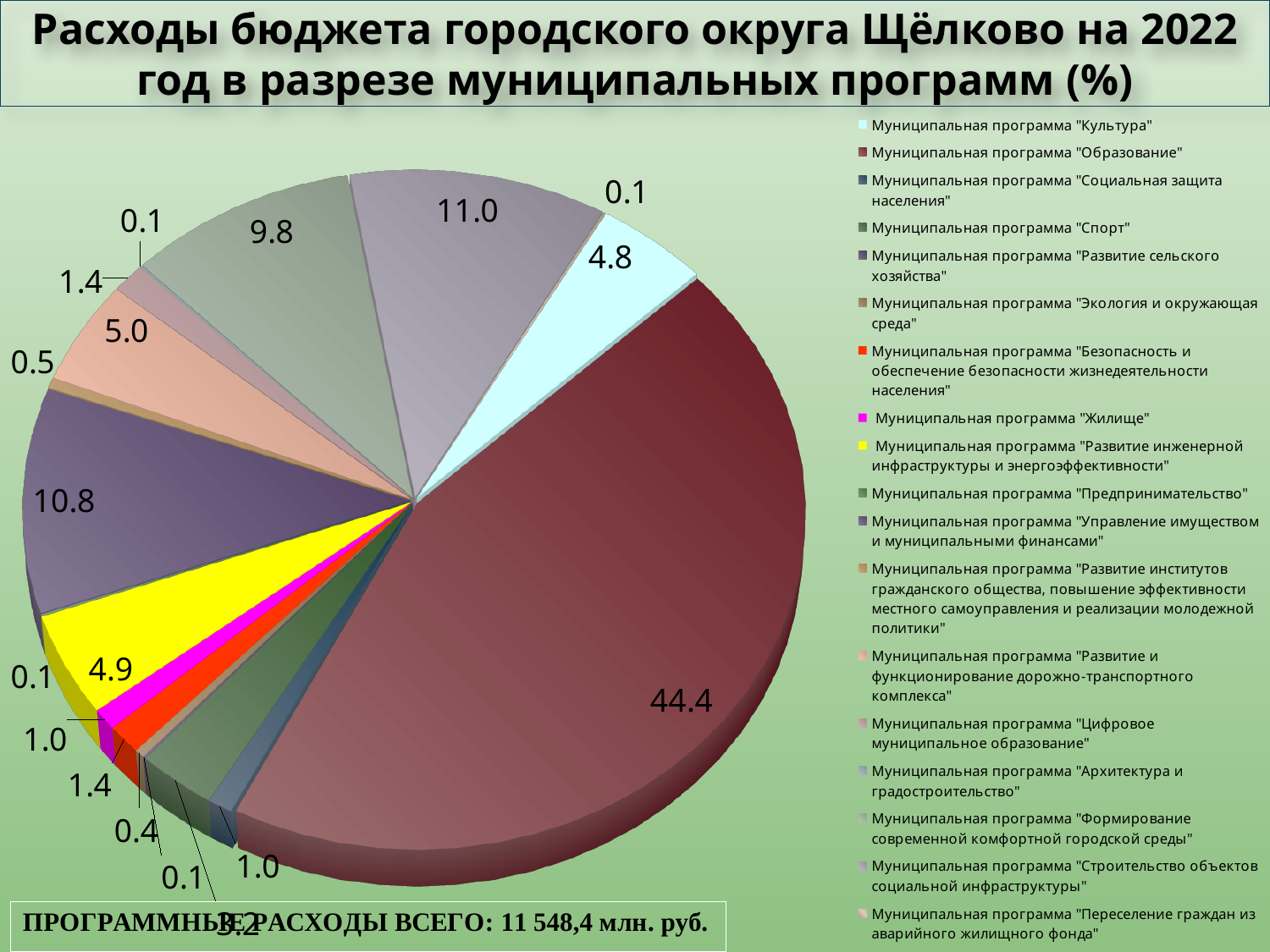
How many municipal programmes are listed in the legend? 18 Is the share for the municipal programme "Образование" greater or less than 40? greater What percentage is shown for the municipal programme "Развитие инженерной инфраструктуры и энергоэффективности" (yellow slice)? 4.9 What percentage is shown for the municipal programme "Жилище" (magenta slice)? 1.0 Which municipal programme has the largest share of the 2022 budget expenditure? Муниципальная программа "Образование" What percentage of expenditure goes to the municipal programme "Культура"? 4.8 What percentage of expenditure goes to the municipal programme "Образование"? 44.4 Which slice is larger: "Управление имуществом и муниципальными финансами" (10.8) or "Формирование современной комфортной городской среды" (9.8)? Управление имуществом и муниципальными финансами What is the difference in percentage points between the "Образование" slice (44.4) and the "Строительство объектов социальной инфраструктуры" slice (11.0)? 33.4 What kind of chart is shown on the slide? pie chart What total programme expenditure amount is stated at the bottom of the slide? 11 548,4 млн. руб. What percentage is shown for the municipal programme "Строительство объектов социальной инфраструктуры"? 11.0